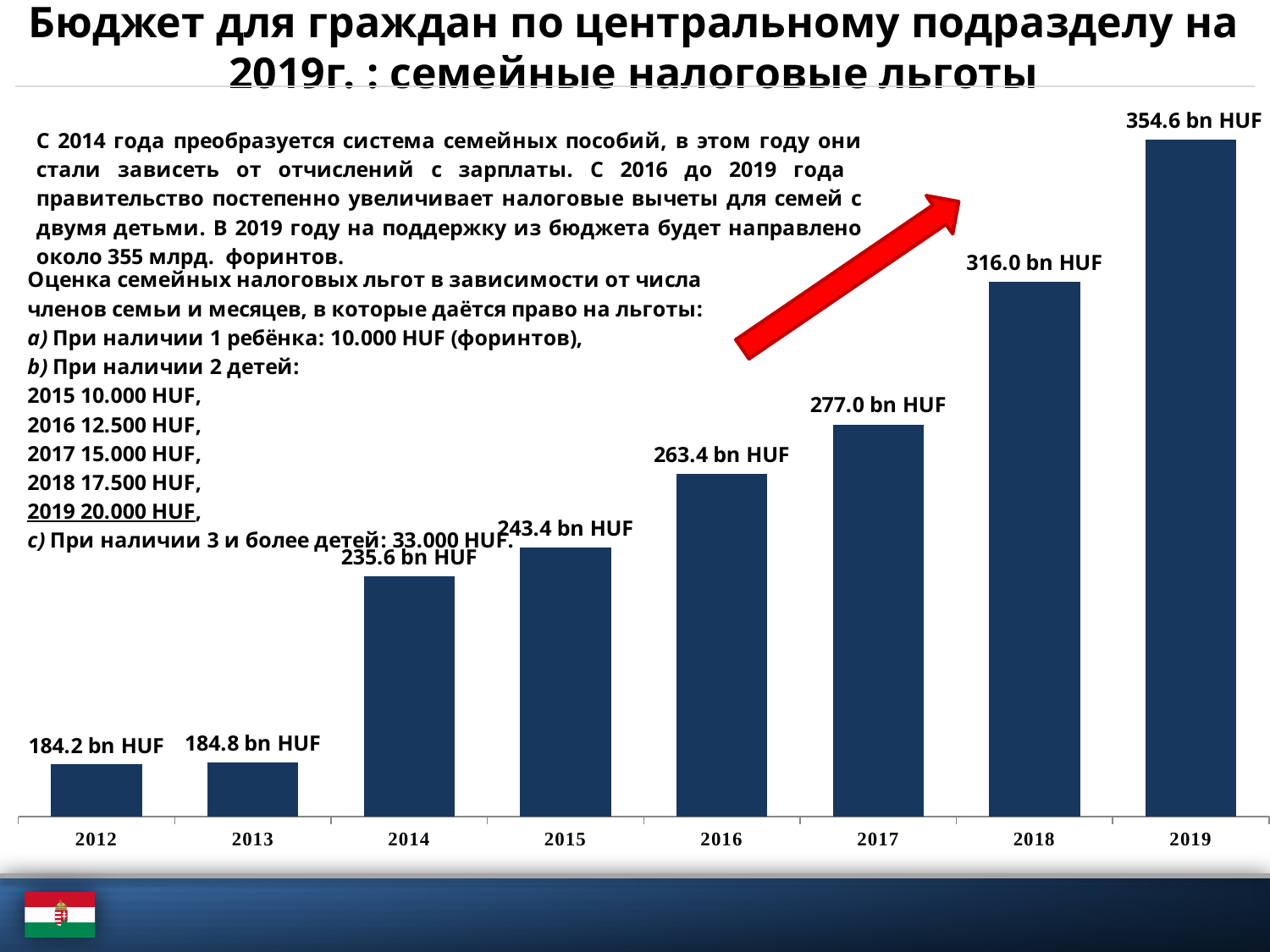
How many years are shown on the x axis? 8 What is the difference between the values for 2014 and 2013? 50.8 bn HUF Which year has the highest value? 2019 What is the value for 2016? 263.4 bn HUF What is the difference between the values for 2019 and 2018? 38.6 bn HUF What is the value for 2012? 184.2 bn HUF What is the value for 2019? 354.6 bn HUF What kind of chart is shown on the slide? bar chart What is the value for 2014? 235.6 bn HUF What is the difference between the values for 2019 and 2012? 170.4 bn HUF Do the values rise or fall from 2012 to 2019? rise Which is larger, the value for 2017 or the value for 2015? 2017